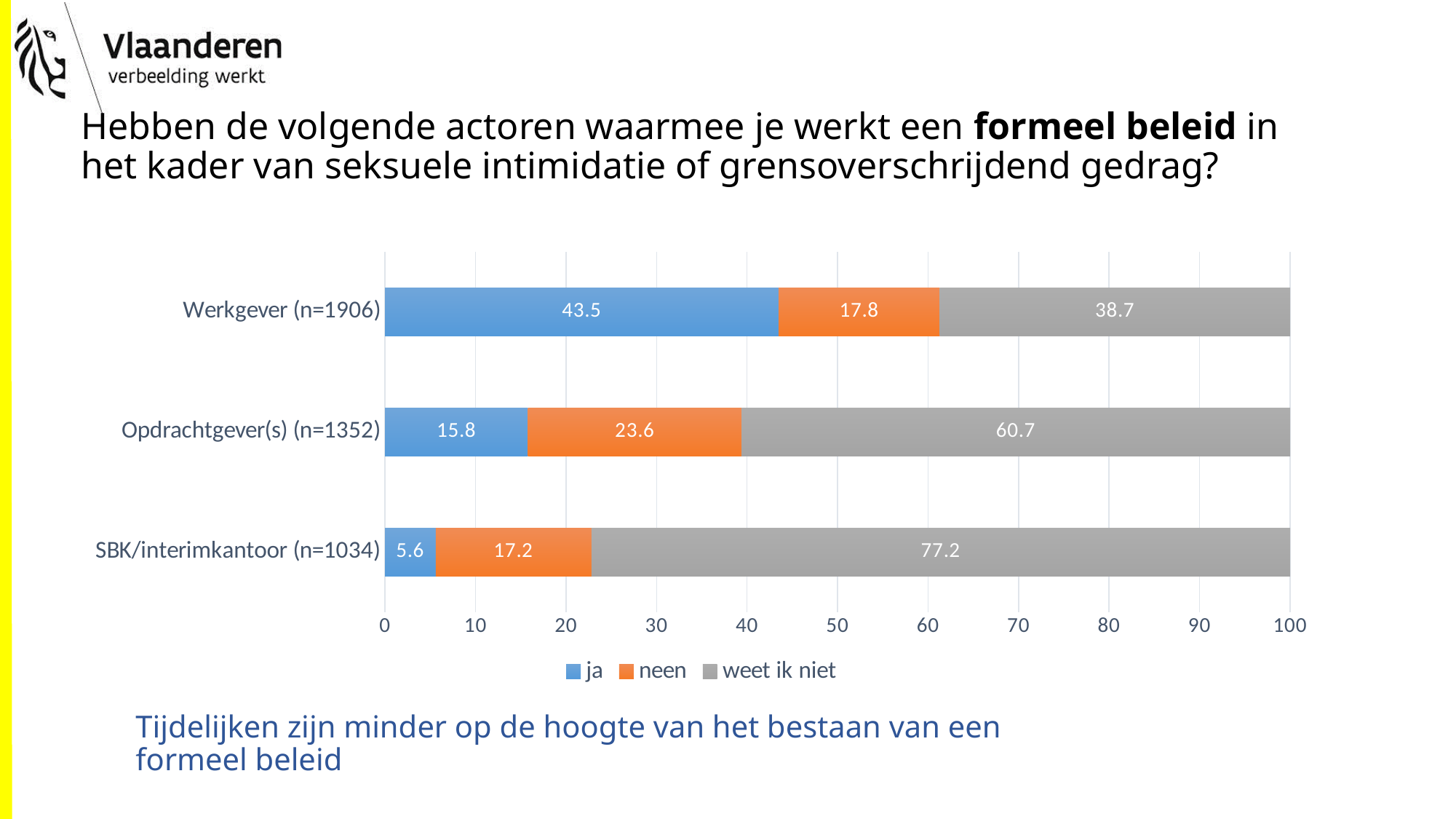
Which is larger: the 'neen' value for Opdrachtgever(s) (n=1352) or the 'neen' value for Werkgever (n=1906)? Opdrachtgever(s) (n=1352) Which category has the highest 'ja' value? Werkgever (n=1906) How many series does the legend list? 3 What is the 'weet ik niet' value for SBK/interimkantoor (n=1034)? 77.2 How many categories are shown on the chart? 3 Which category has the lowest 'weet ik niet' value? Werkgever (n=1906) What is the 'ja' value for Werkgever (n=1906)? 43.5 What is the difference between the 'weet ik niet' values for SBK/interimkantoor (n=1034) and Werkgever (n=1906)? 38.5 What is the 'neen' value for Opdrachtgever(s) (n=1352)? 23.6 Which series is shown in orange in the legend? neen What is the total of the stacked bar for Opdrachtgever(s) (n=1352)? 100.1 What kind of chart is shown on the slide? Stacked bar chart